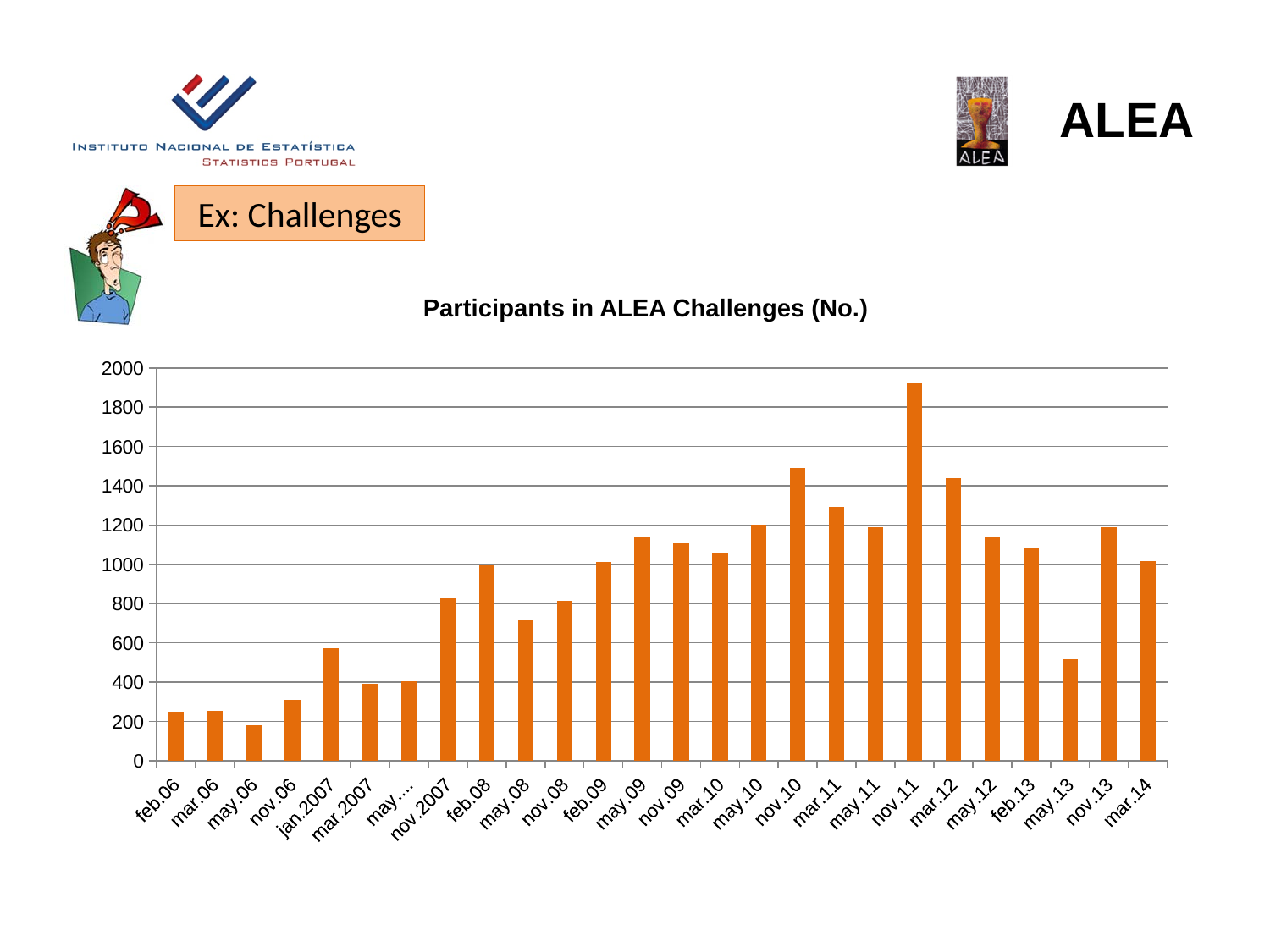
Is the value for nov.11 greater or less than 1800? greater Which has more participants, nov.10 or mar.11? nov.10 Which period has the lowest number of participants? may.06 What is the title of the chart? Participants in ALEA Challenges (No.) What kind of chart is shown on the slide? bar chart Is the value for may.06 greater or less than 200? less Is the value for may.13 greater or less than 600? less Do the values generally rise or fall from feb.06 to nov.11? rise Which period has the highest number of participants? nov.11 How many bars (time periods) are plotted in the chart? 26 Which has more participants, mar.12 or may.12? mar.12